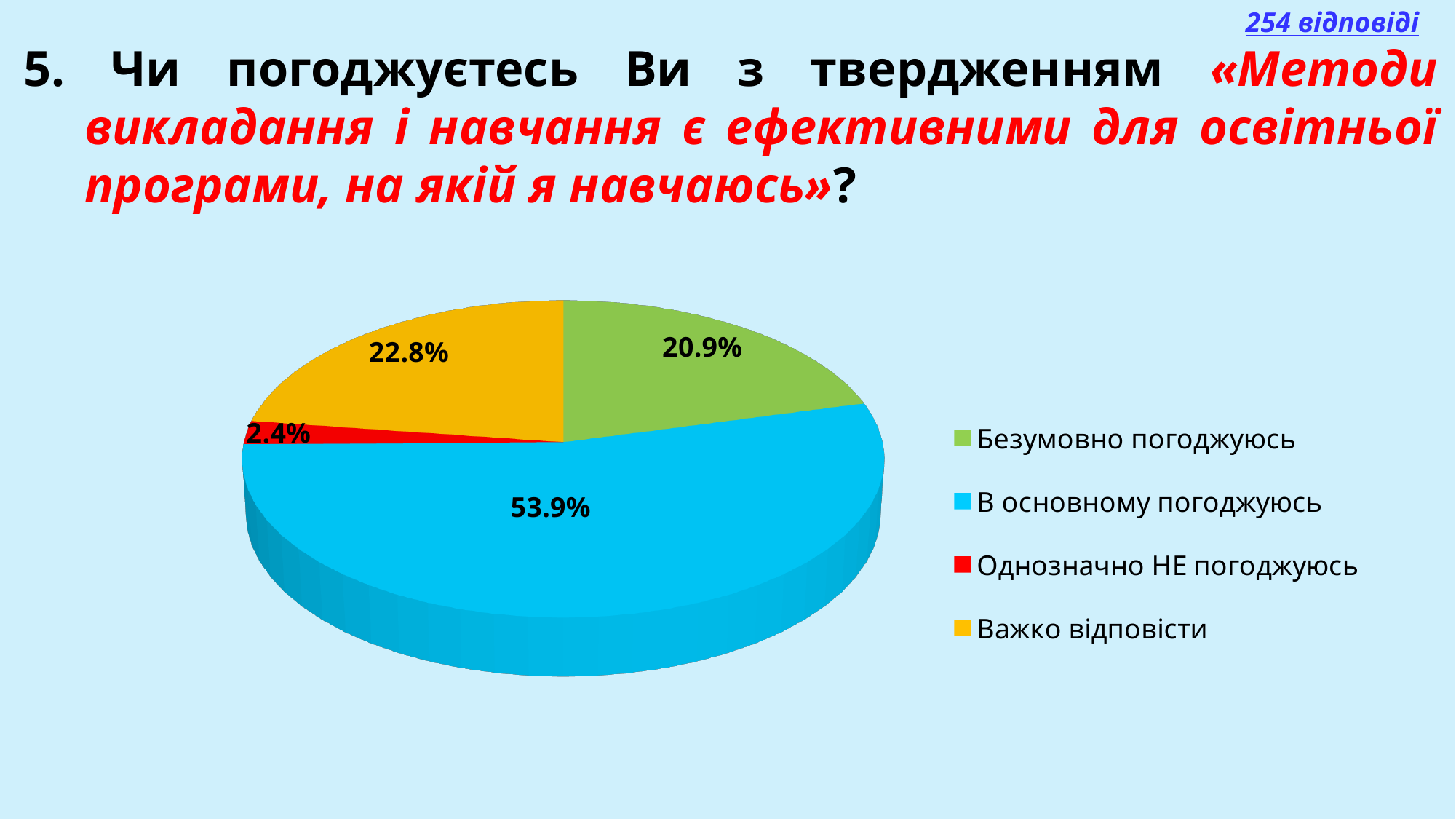
What is the difference between the shares of "В основному погоджуюсь" and "Безумовно погоджуюсь"? 33.0% What colour is the slice for "Важко відповісти"? Yellow What share of the pie does "В основному погоджуюсь" have? 53.9% How many slices does the pie chart have? 4 What share of the pie does "Важко відповісти" have? 22.8% Which is larger: the share of "Важко відповісти" or the share of "Безумовно погоджуюсь"? Важко відповісти Which category has the largest slice of the pie? В основному погоджуюсь What share of the pie does "Однозначно НЕ погоджуюсь" have? 2.4% What share of the pie does "Безумовно погоджуюсь" have? 20.9% What kind of chart is shown on the slide? Pie chart Which category has the smallest slice of the pie? Однозначно НЕ погоджуюсь How many entries does the legend list? 4